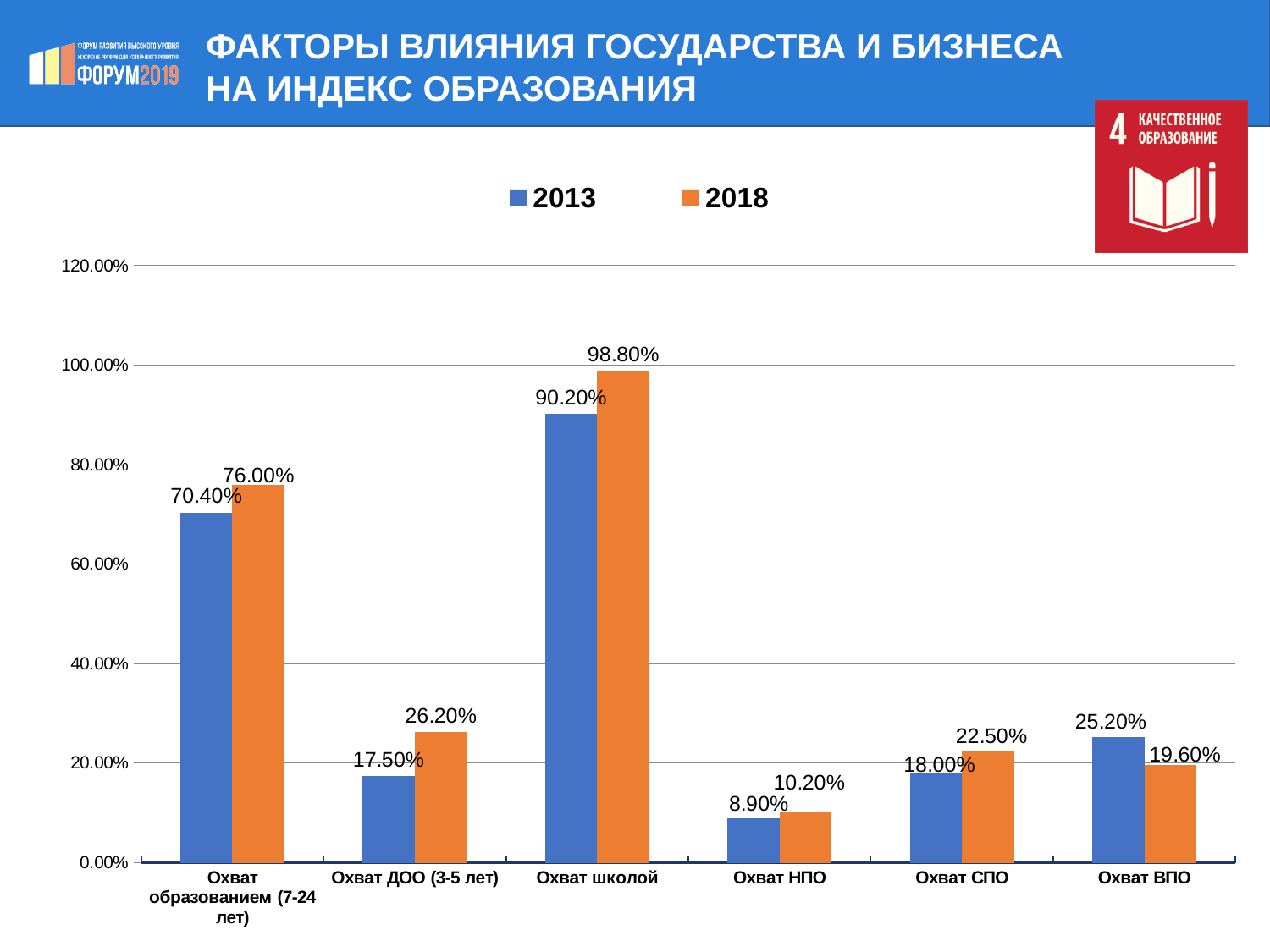
Which colour represents the 2018 series in the legend? Orange Which category has the lowest 2013 value? Охват НПО How many series does the legend list? 2 Which category has the highest 2018 value? Охват школой What is the 2013 value for Охват ВПО? 25.20% What is the 2018 value for Охват школой? 98.80% What is the difference between the 2018 and 2013 values for Охват образованием (7-24 лет)? 5.60% For Охват ВПО, which year has the larger value, 2013 or 2018? 2013 What is the 2013 value for Охват ДОО (3-5 лет)? 17.50% How many categories are shown on the x axis? 6 Is the 2018 value for Охват СПО greater or less than 20.00%? greater What kind of chart is shown on the slide? Bar chart